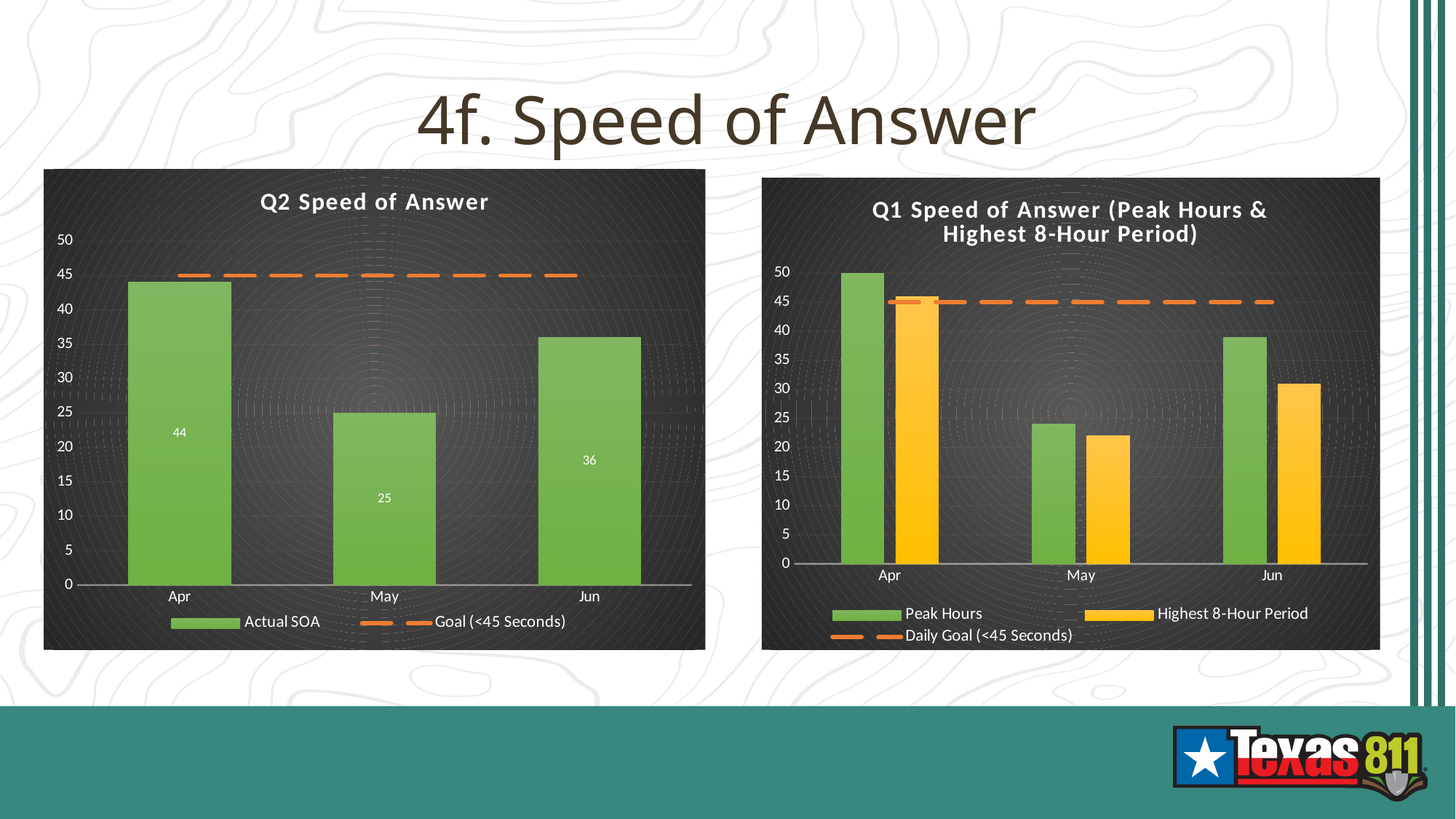
In the Q1 Speed of Answer chart, is the Highest 8-Hour Period value for Jun greater or less than 35? less In the Q2 Speed of Answer chart, which month has the highest Actual SOA? Apr In the Q1 Speed of Answer chart, is the Peak Hours value for Jun higher or lower than the Highest 8-Hour Period value for Jun? higher In the Q2 Speed of Answer chart, what is the difference between the Actual SOA for Apr and Jun? 8 In the Q2 Speed of Answer chart, what is the Actual SOA value for Apr? 44 In the Q2 Speed of Answer chart, which month has the lowest Actual SOA? May In the Q2 Speed of Answer chart, is the Actual SOA higher in May or in Jun? Jun How many series does the legend of the Q1 Speed of Answer chart list? 3 In the Q2 Speed of Answer chart, how many months are shown on the x axis? 3 In the Q1 Speed of Answer chart, is the Peak Hours value for Apr greater or less than 45? greater What kind of chart is the Q2 Speed of Answer chart? Bar chart In the Q2 Speed of Answer chart, what is the Actual SOA value for May? 25